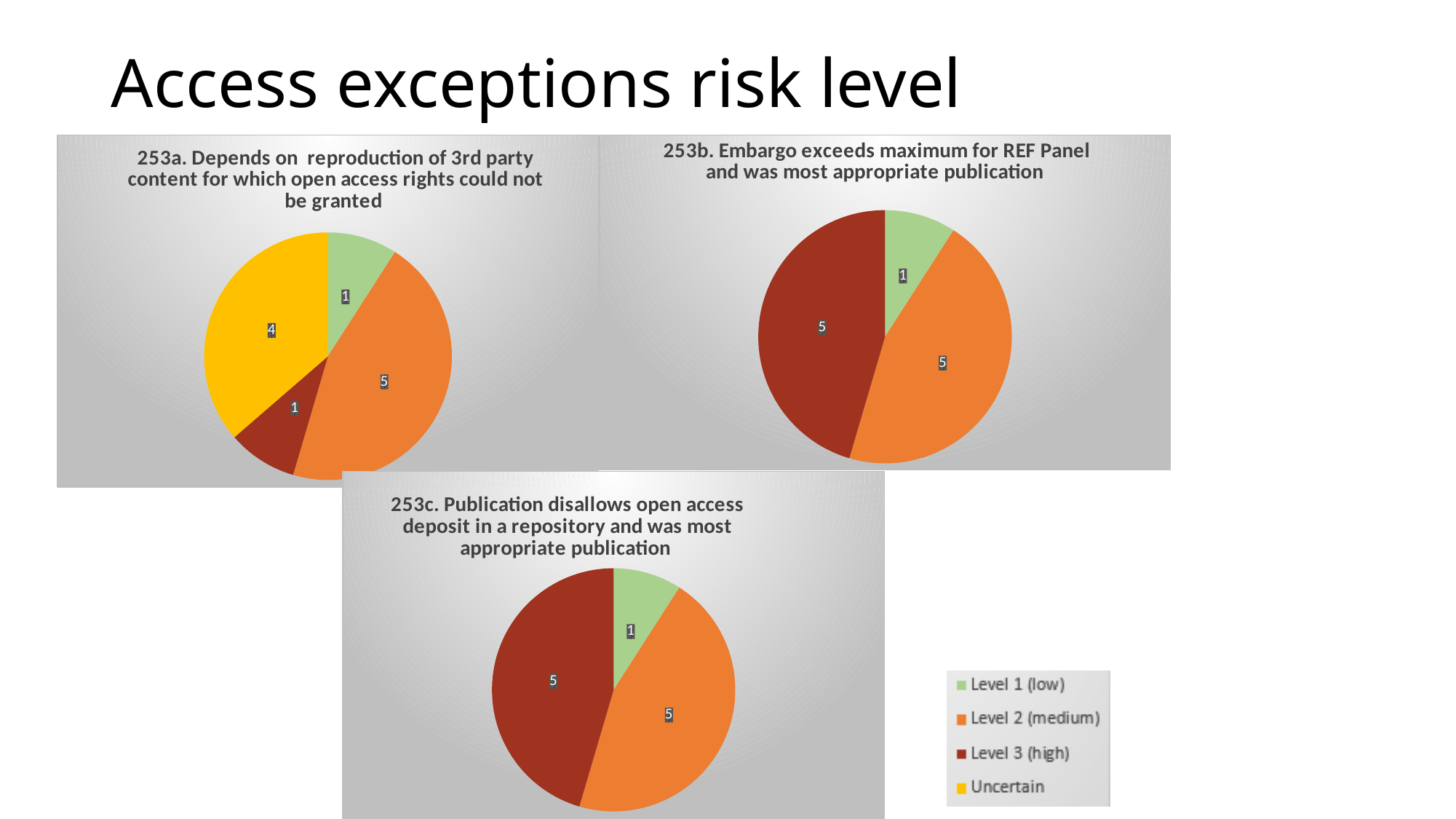
In the 253a chart, which category has the largest slice? Level 2 (medium) In the 253b. Embargo exceeds maximum for REF Panel chart, what is the value for Level 3 (high)? 5 In the 253c. Publication disallows open access deposit chart, what is the value for Level 1 (low)? 1 In the 253a chart, what is the value for Uncertain? 4 How many entries does the legend list? 4 In the 253a chart, what is the value for Level 2 (medium)? 5 In the 253a chart, how many slices does the pie have? 4 In the 253a chart, what is the difference between Level 2 (medium) and Uncertain? 1 In the 253b chart, what is the total of all slices? 11 In the 253c chart, is the value for Level 3 (high) larger or smaller than the value for Level 1 (low)? Larger What type of chart is used for 253a. Depends on reproduction of 3rd party content? Pie chart In the 253b chart, which category has the smallest slice? Level 1 (low)